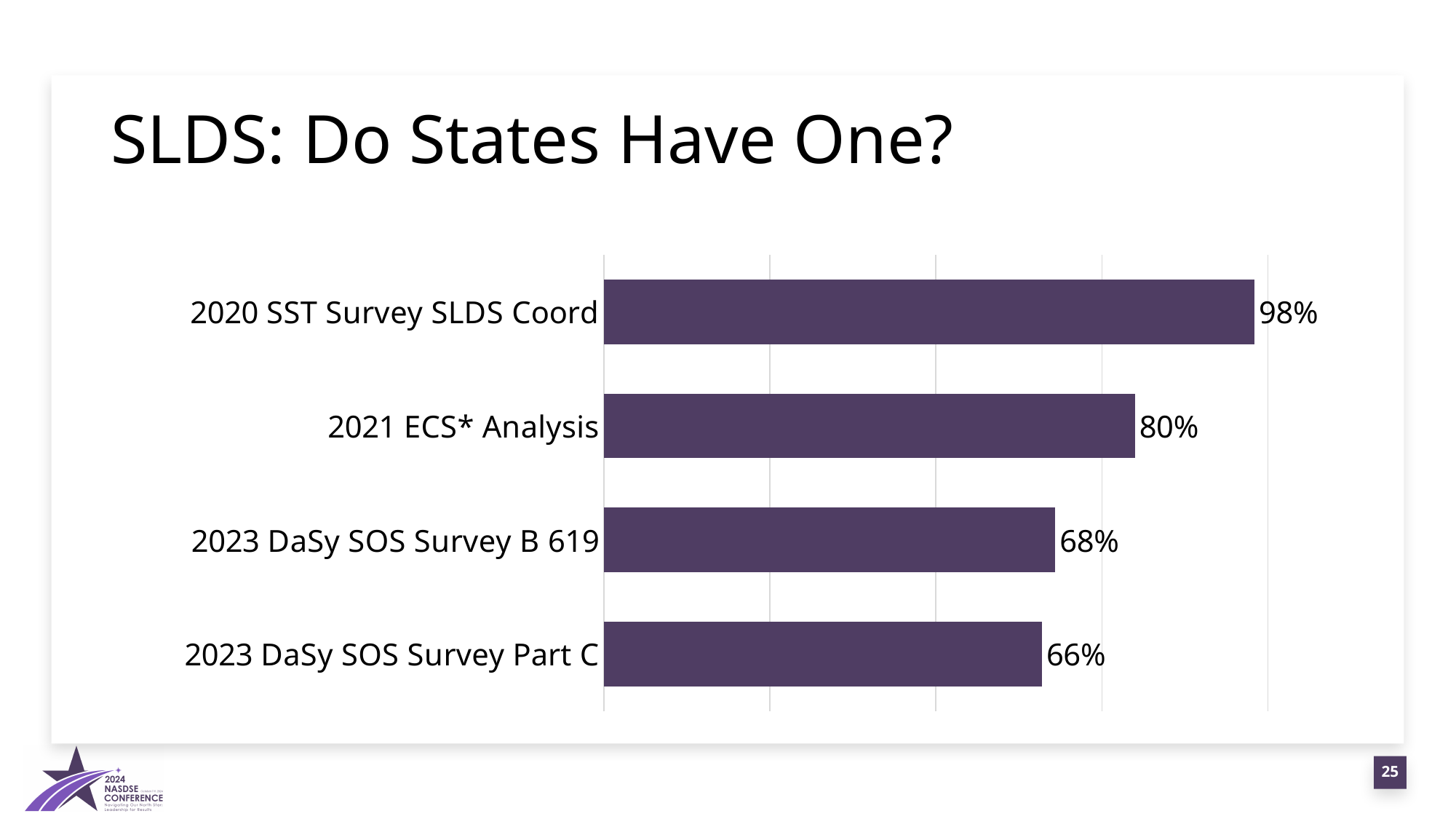
What is the value for 2023 DaSy SOS Survey Part C? 66% Which category has the lowest value? 2023 DaSy SOS Survey Part C What is the value for 2021 ECS* Analysis? 80% What is the difference between the values for 2020 SST Survey SLDS Coord and 2021 ECS* Analysis? 18% What is the difference between the values for 2023 DaSy SOS Survey B 619 and 2023 DaSy SOS Survey Part C? 2% Which category has the highest value? 2020 SST Survey SLDS Coord What is the title of the slide containing the chart? SLDS: Do States Have One? What kind of chart is shown on the slide? Bar chart How many categories are shown in the chart? 4 What is the value for 2023 DaSy SOS Survey B 619? 68% What is the value for 2020 SST Survey SLDS Coord? 98% Which is larger, the value for 2021 ECS* Analysis or the value for 2023 DaSy SOS Survey B 619? 2021 ECS* Analysis